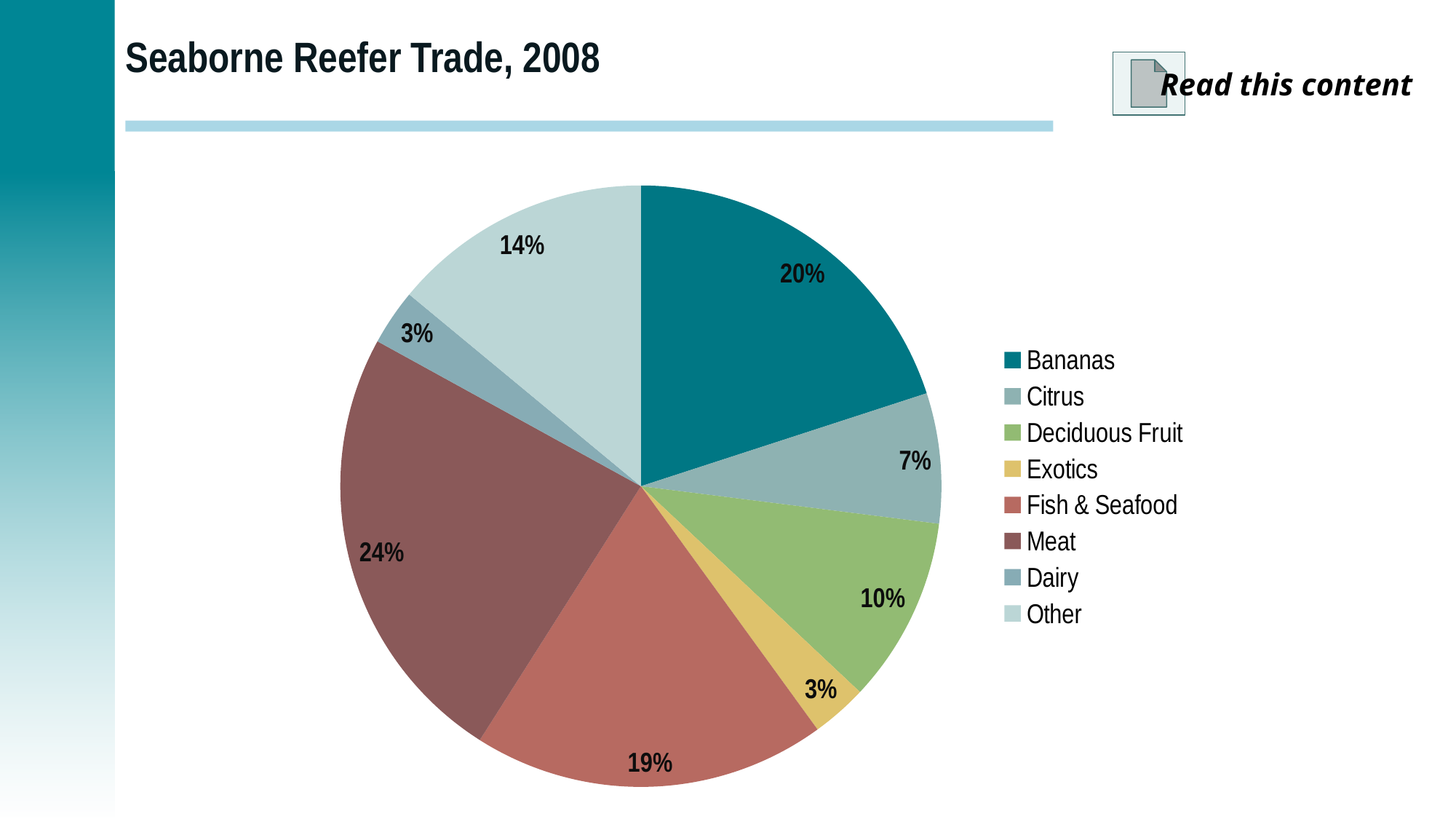
What is the value shown for Other? 14% What is the value shown for Deciduous Fruit? 10% Which is larger, the share for Citrus or the share for Deciduous Fruit? Deciduous Fruit What is the difference between the shares of Fish & Seafood and Other? 5% What is the title of the chart? Seaborne Reefer Trade, 2008 Which category has the largest share of the pie? Meat What share of the pie does Meat have? 24% What kind of chart is shown on the slide? Pie chart What is the difference between the shares of Meat and Bananas? 4% How many categories does the pie chart show? 8 What is the value shown for Fish & Seafood? 19% What share of the pie does Bananas have? 20%